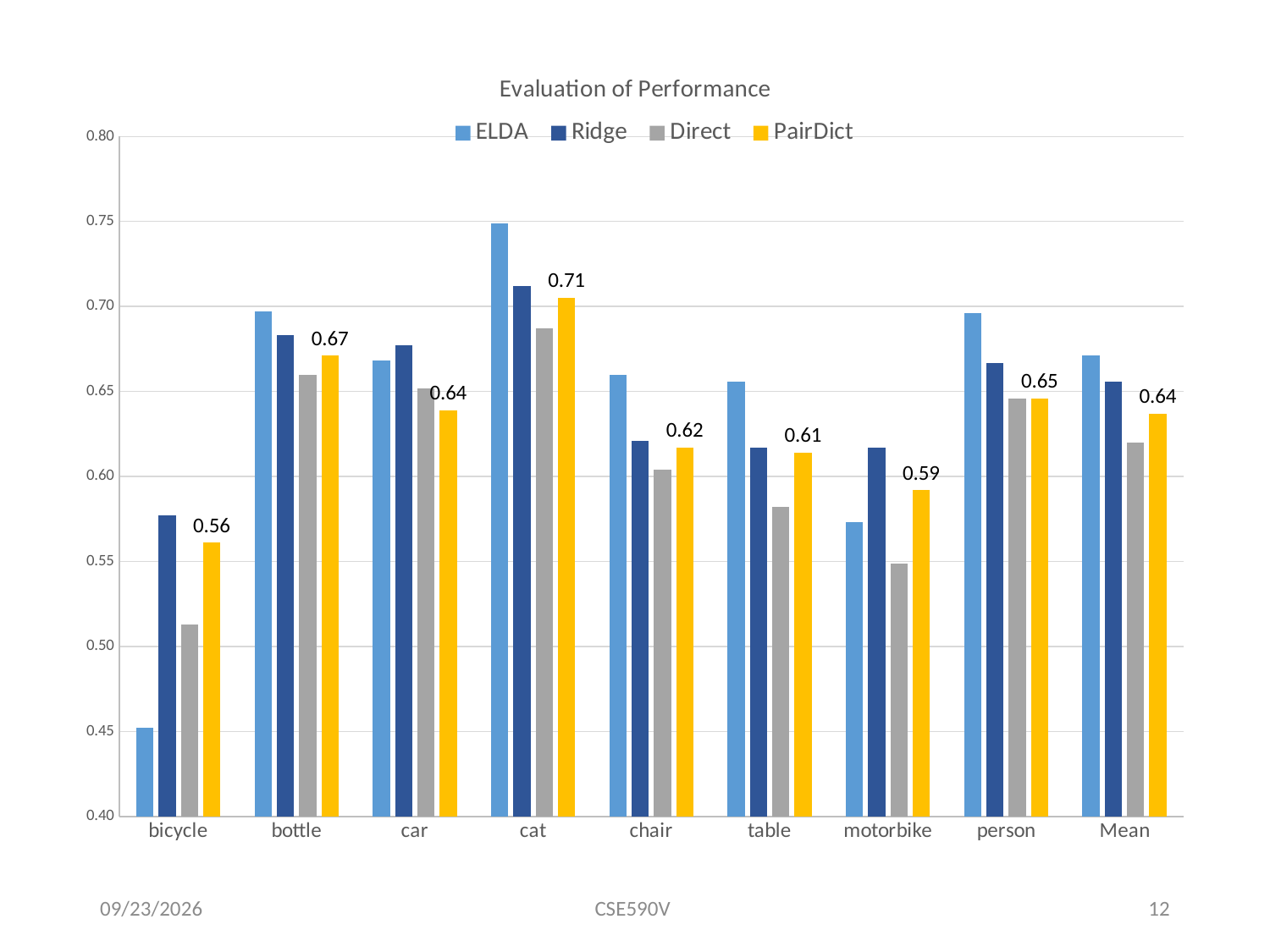
Which category has the highest PairDict value? cat Which category has the lowest PairDict value? bicycle How many categories are shown on the x axis? 9 How many series does the legend list? 4 What is the PairDict value for bicycle? 0.56 What is the PairDict value for cat? 0.71 What type of chart is shown on the slide? bar chart Which has the larger PairDict value, bottle or car? bottle What is the difference between the PairDict values for cat and bicycle? 0.15 Is the ELDA value for bicycle greater or less than 0.50? less Is the ELDA value for cat greater or less than 0.70? greater What is the PairDict value for Mean? 0.64